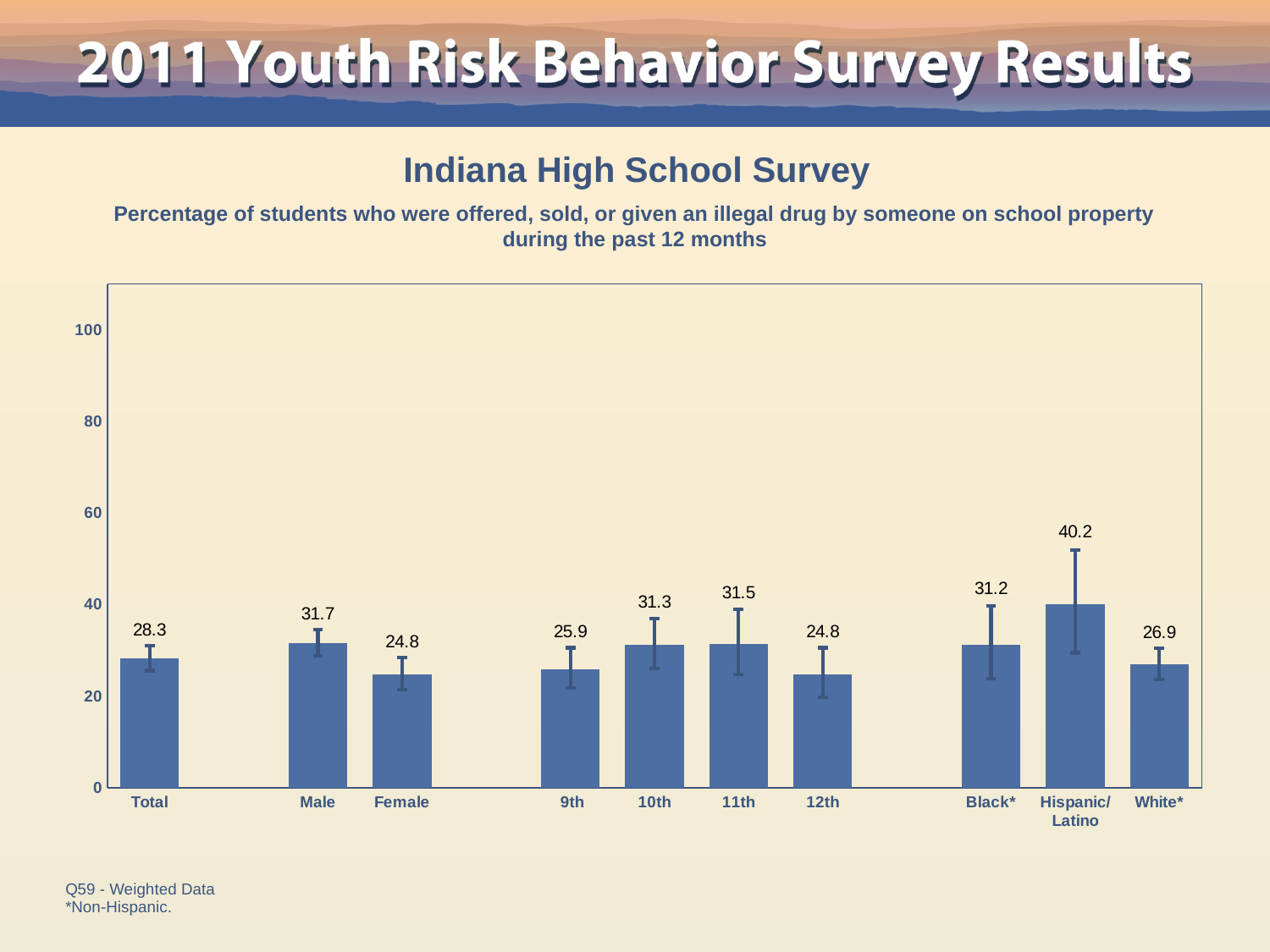
What is the value for Total? 28.3 What is the value for 11th grade? 31.5 How many categories are shown on the x axis? 10 What is the value for Hispanic/Latino students? 40.2 Is the value for White* greater or less than 40? less Which is larger, the value for 10th grade or the value for 12th grade? 10th What is the difference between the Hispanic/Latino and Black* values? 9.0 What is the maximum value shown on the y axis? 100 What is the value for 9th grade? 25.9 What is the difference between the Male and Female values? 6.9 What kind of chart is this? bar chart Which category has the highest value? Hispanic/Latino